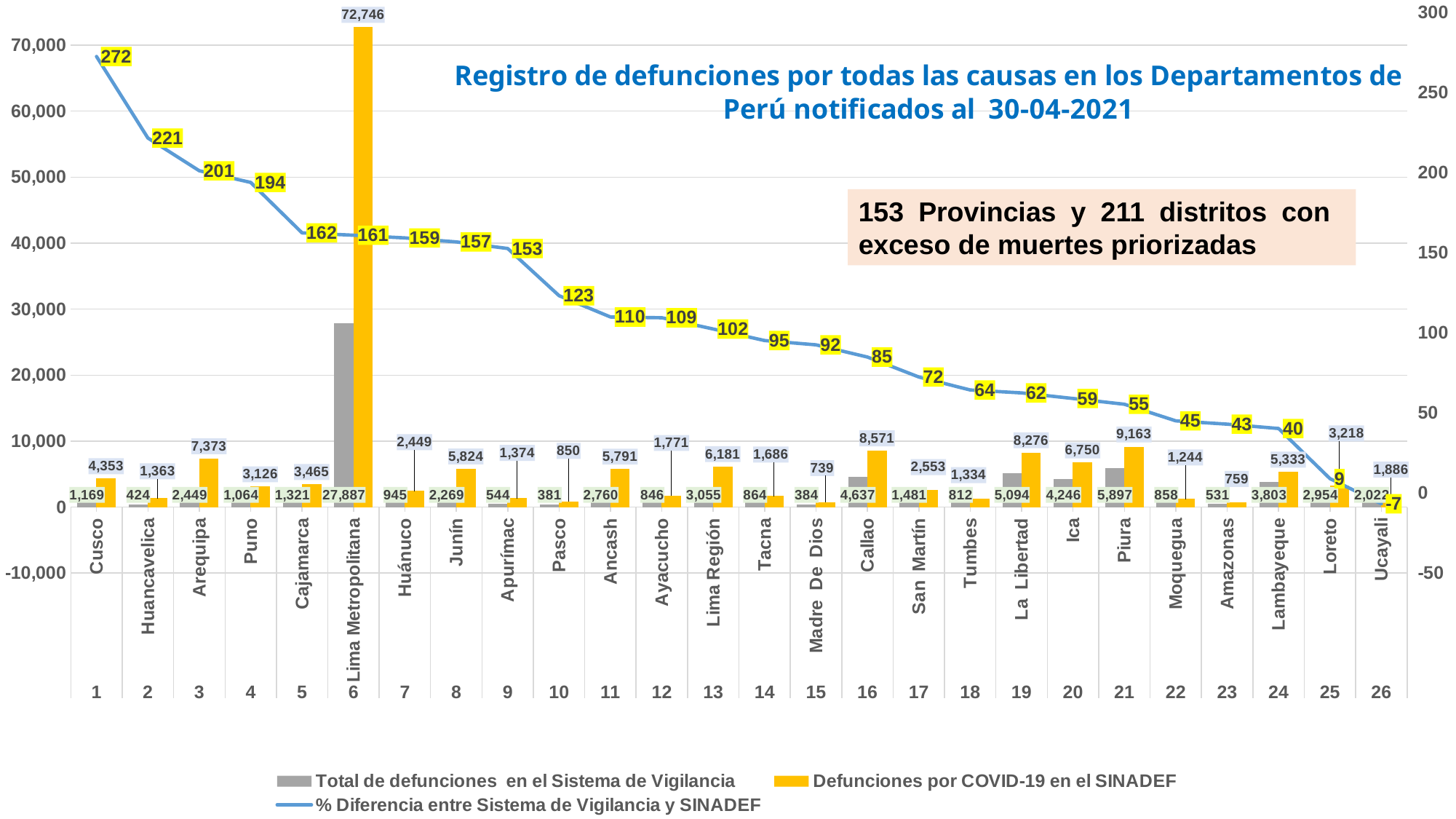
For Callao, what is the difference between Defunciones por COVID-19 en el SINADEF and Total de defunciones en el Sistema de Vigilancia? 3,934 Which department has the lowest % Diferencia entre Sistema de Vigilancia y SINADEF? Ucayali Which department has the highest value of Defunciones por COVID-19 en el SINADEF? Lima Metropolitana What kind of chart is this? Combination bar and line chart What is the Total de defunciones en el Sistema de Vigilancia for Piura? 5,897 What is the % Diferencia entre Sistema de Vigilancia y SINADEF for Cusco? 272 Which has more Defunciones por COVID-19 en el SINADEF, Ica or La Libertad? La Libertad How many departments are shown on the x axis? 26 What is the % Diferencia entre Sistema de Vigilancia y SINADEF for Loreto? 9 Does the % Diferencia entre Sistema de Vigilancia y SINADEF line rise or fall from Cusco to Ucayali? Fall How many series does the legend list? 3 What is the value of Defunciones por COVID-19 en el SINADEF for Arequipa? 7,373